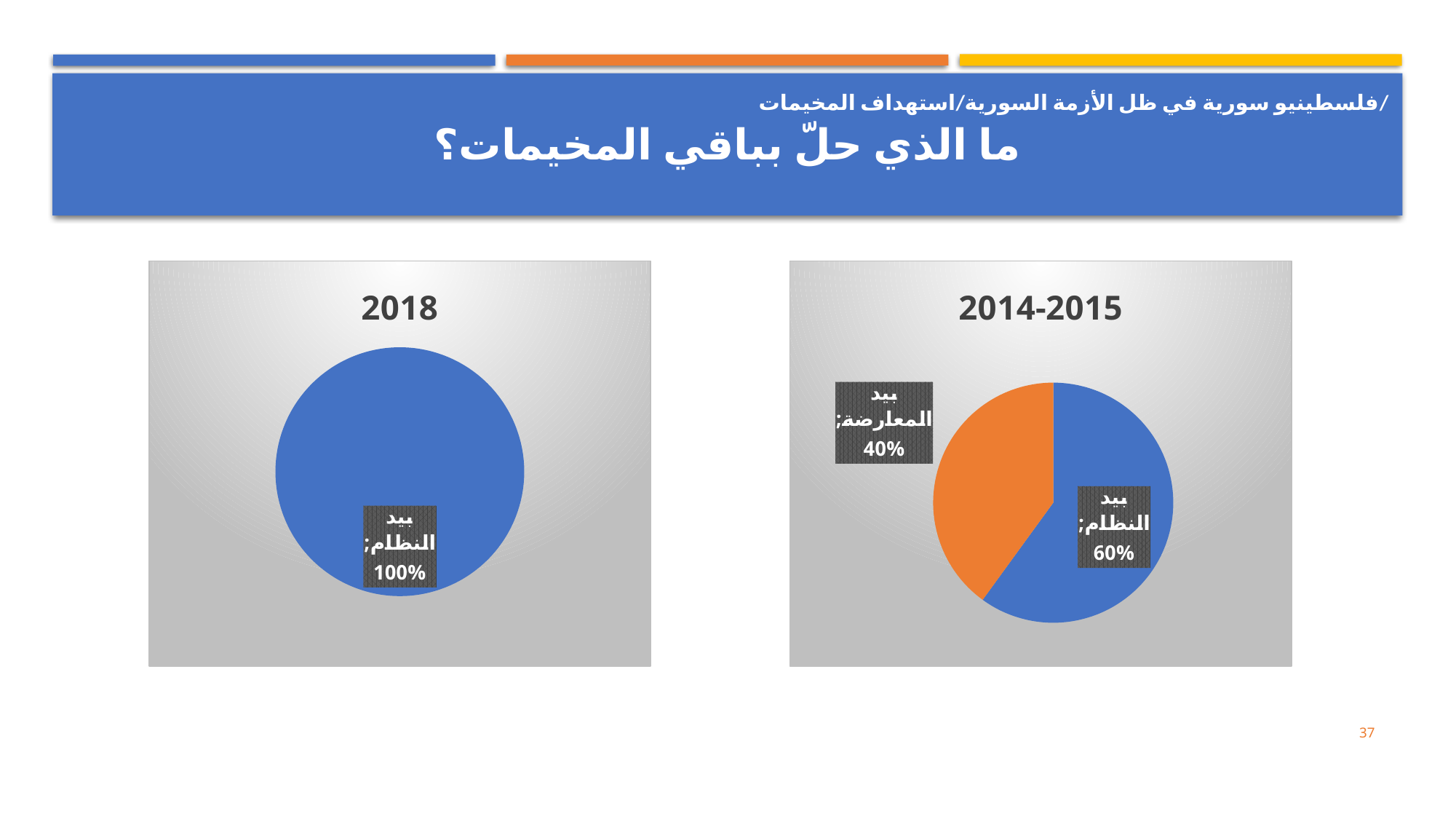
What kind of chart is the chart titled "2018"? Pie chart In the chart titled "2014-2015", which slice is the largest? بيد النظام In the chart titled "2014-2015", what colour is the "بيد المعارضة" slice? Orange How many slices does the chart titled "2018" have? 1 In the chart titled "2018", what share of the pie is labelled "بيد النظام"? 100% In the chart titled "2014-2015", which slice is the smallest? بيد المعارضة In the chart titled "2014-2015", what share of the pie is labelled "بيد المعارضة"? 40% How many slices does the chart titled "2014-2015" have? 2 In the chart titled "2014-2015", which is larger: "بيد النظام" or "بيد المعارضة"? بيد النظام What is the title of the chart on the left side of the slide? 2018 In the chart titled "2014-2015", what share of the pie is labelled "بيد النظام"? 60% In the chart titled "2014-2015", what is the difference between the "بيد النظام" share and the "بيد المعارضة" share? 20%